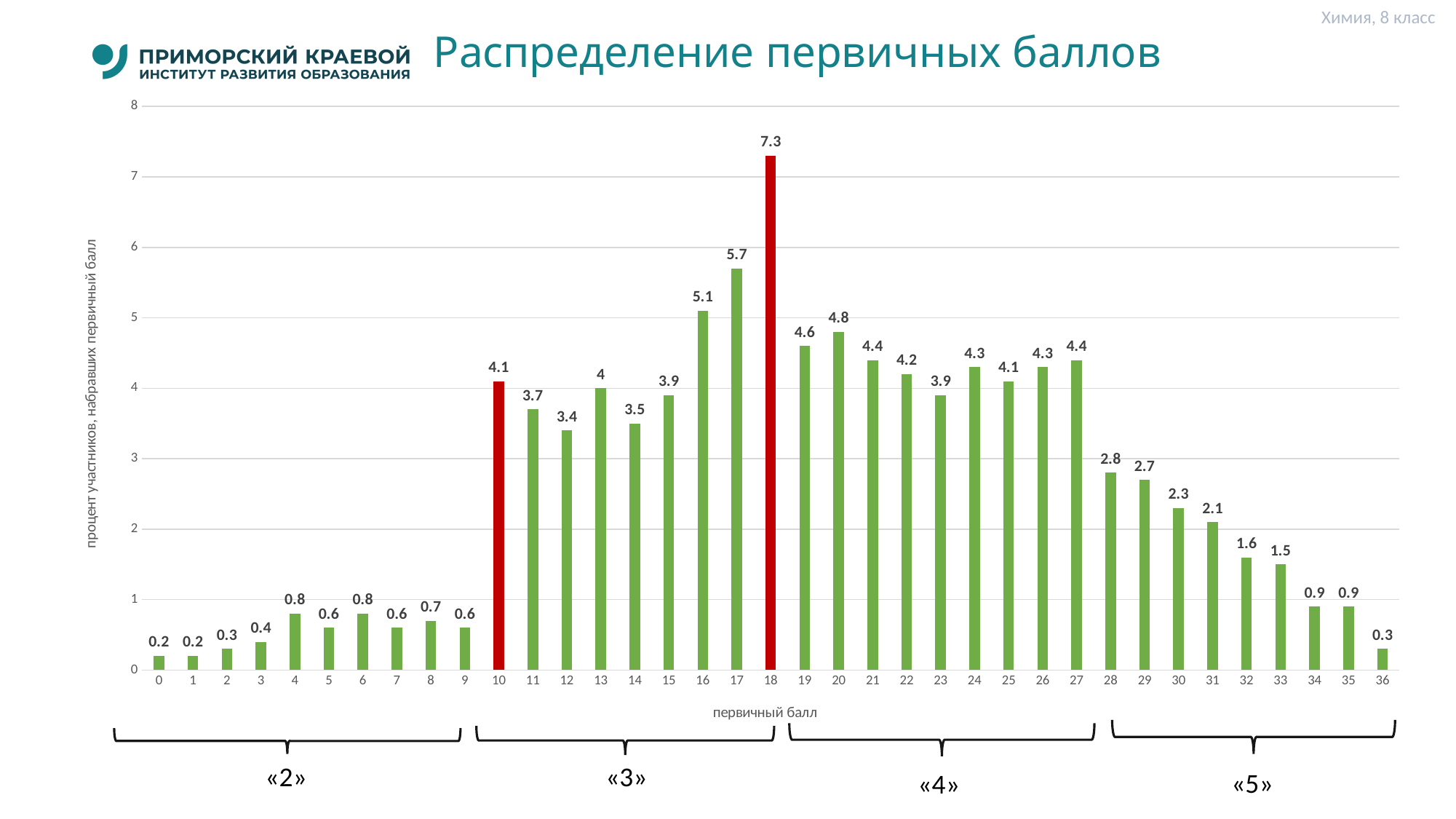
Do the values rise or fall along the x axis from primary score 28 to 36? fall What is the value for primary score 30? 2.3 What is the value for primary score 18? 7.3 Is the value for primary score 28 greater or less than 3? less What is the difference between the values for primary scores 18 and 17? 1.6 Which is larger, the value for primary score 16 or for primary score 20? 16 How many primary score categories are shown on the x axis? 37 What kind of chart is shown on the slide? bar chart What is the lowest value shown on the chart? 0.2 Which primary score has the highest percentage of participants? 18 Which two primary scores are highlighted with red bars? 10 and 18 What is the value for primary score 10? 4.1